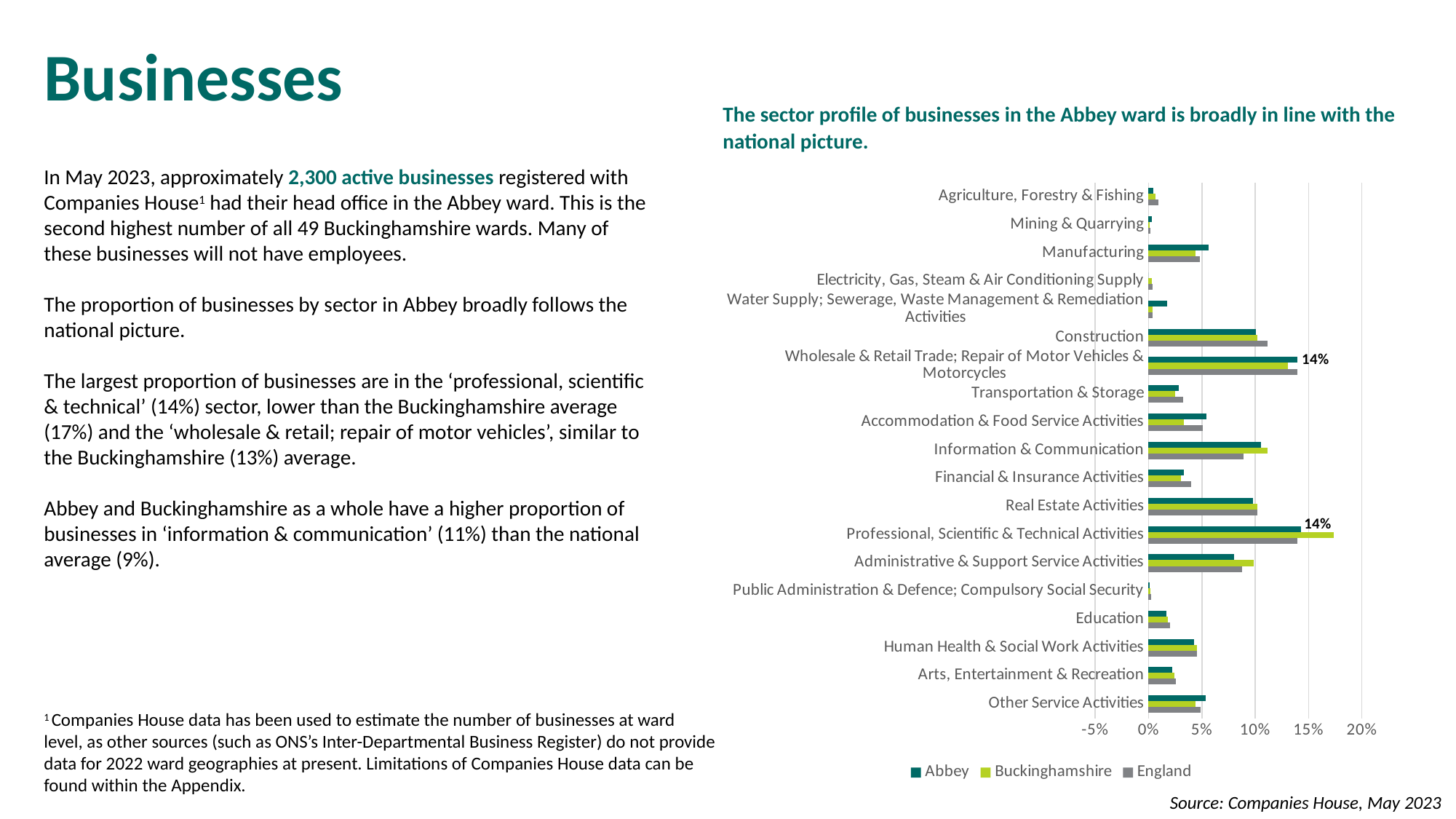
What are the three series named in the chart legend? Abbey, Buckinghamshire, England Is the Abbey value for Construction greater or less than 5%? greater Is the Abbey value for Manufacturing greater or less than 10%? less What is the Abbey value for Wholesale & Retail Trade; Repair of Motor Vehicles & Motorcycles? 14% How many series does the chart legend list? 3 What is the Abbey value for Professional, Scientific & Technical Activities? 14% How many sector categories are plotted on the chart? 19 Which is larger for Abbey: Information & Communication or Education? Information & Communication Which is larger for Abbey: Real Estate Activities or Financial & Insurance Activities? Real Estate Activities Is the Buckinghamshire value for Professional, Scientific & Technical Activities greater or less than 15%? greater What kind of chart is shown on the slide? Bar chart Which sector has the highest Buckinghamshire value? Professional, Scientific & Technical Activities